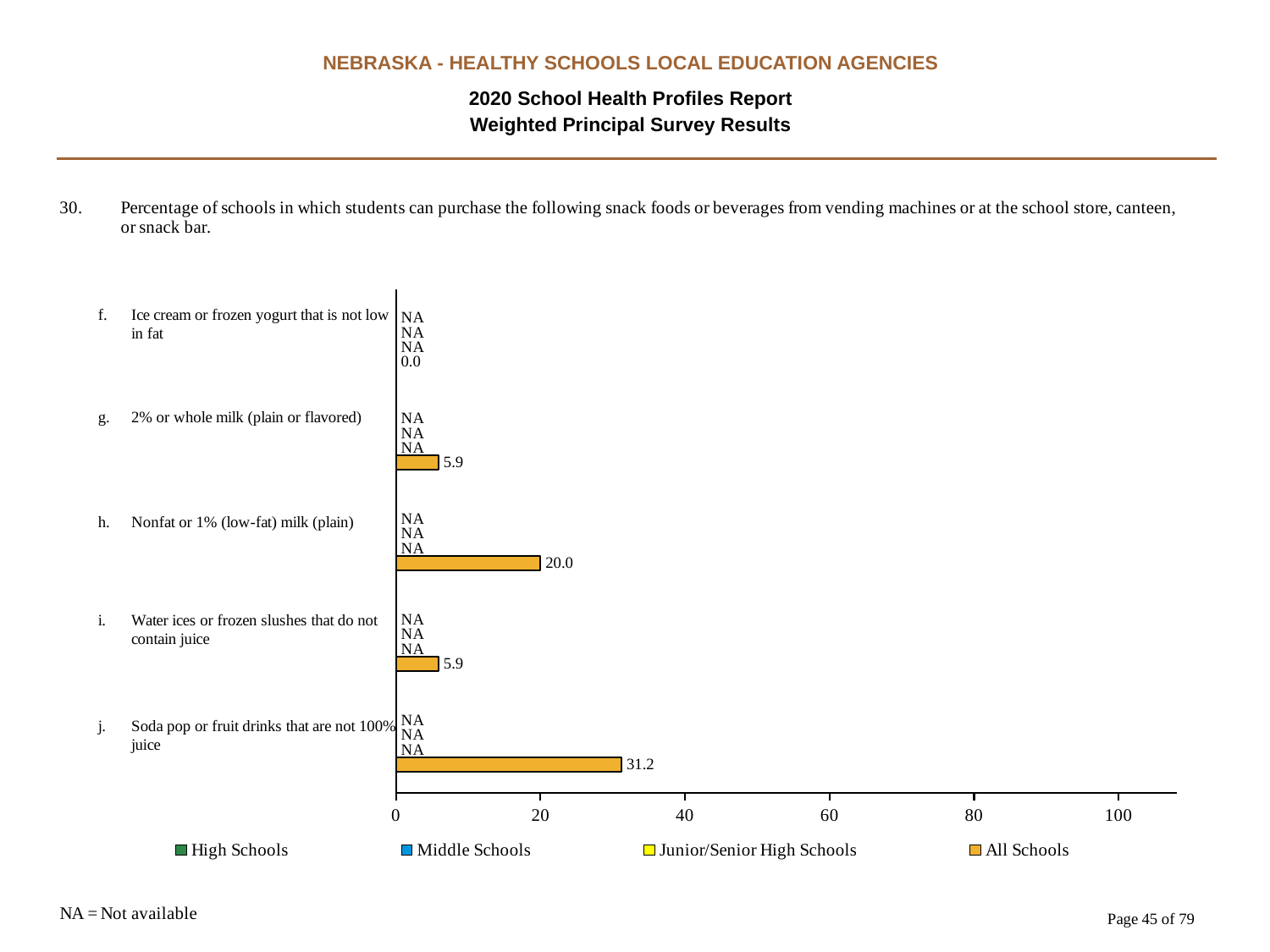
What is the All Schools value for '2% or whole milk (plain or flavored)'? 5.9 How many categories are shown on the chart? 5 How many series does the legend list? 4 What is the High Schools value shown for 'Water ices or frozen slushes that do not contain juice'? NA Which is larger for All Schools: 'Nonfat or 1% (low-fat) milk (plain)' or 'Water ices or frozen slushes that do not contain juice'? Nonfat or 1% (low-fat) milk (plain) What kind of chart is shown on the slide? Bar chart What is the All Schools value for 'Soda pop or fruit drinks that are not 100% juice'? 31.2 What is the All Schools value for 'Nonfat or 1% (low-fat) milk (plain)'? 20.0 Which category has the lowest All Schools value? Ice cream or frozen yogurt that is not low in fat What is the All Schools value for 'Ice cream or frozen yogurt that is not low in fat'? 0.0 What is the difference between the All Schools values for 'Soda pop or fruit drinks that are not 100% juice' and 'Nonfat or 1% (low-fat) milk (plain)'? 11.2 Which category has the highest All Schools value? Soda pop or fruit drinks that are not 100% juice